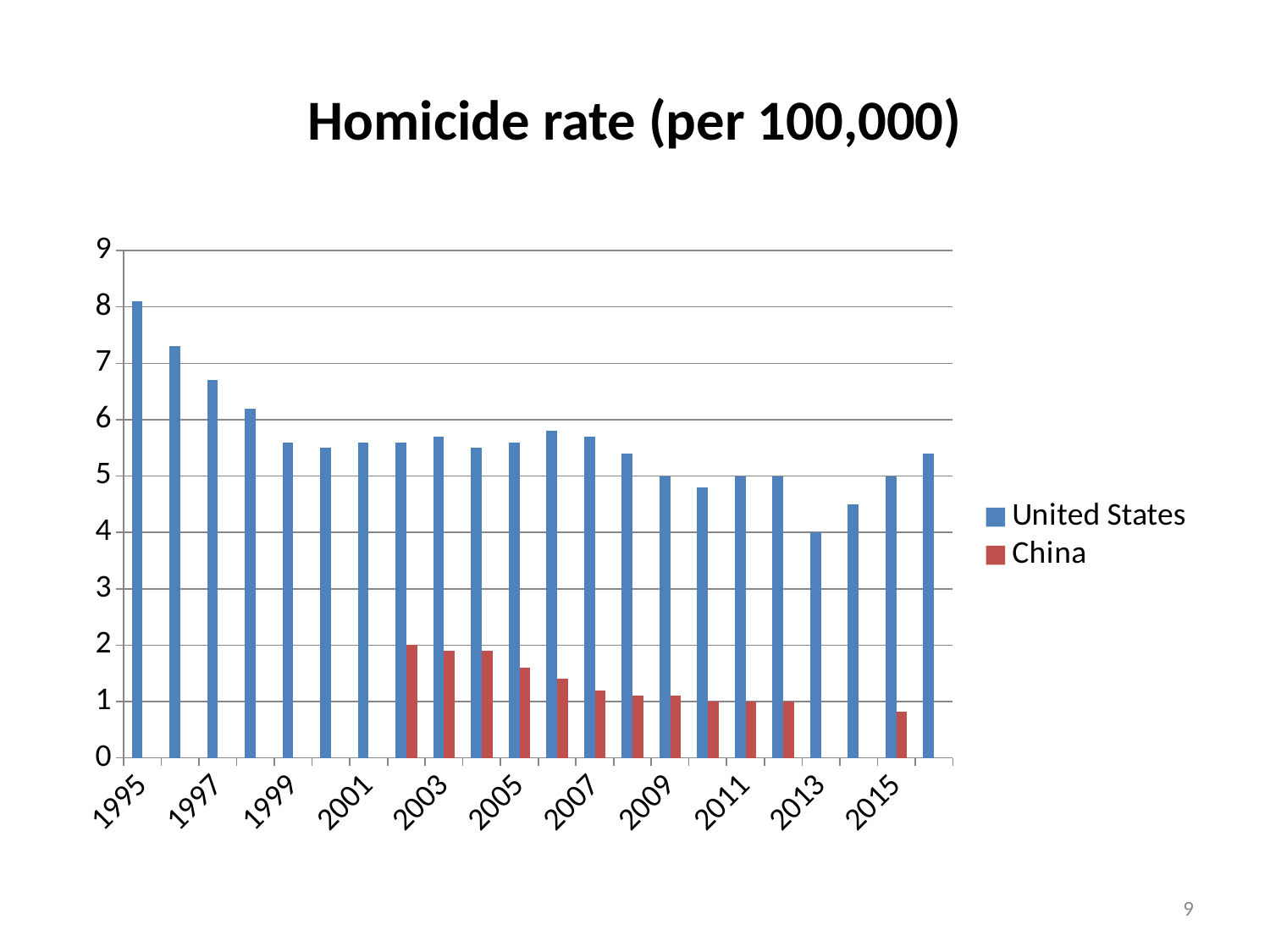
Is the China value for 2002 greater or less than 1? greater Is the United States value for 1995 greater or less than 7? greater In which year is the United States homicide rate lowest? 2013 How many series does the legend list? 2 What kind of chart is shown on the slide? Bar chart Is the United States value for 2013 greater or less than 5? less Which is larger, the China value for 2002 or the China value for 2012? 2002 Does the United States homicide rate generally rise or fall from 1995 to 2013? Fall Which is larger, the United States value for 1995 or the United States value for 2016? 1995 What is the title of the chart? Homicide rate (per 100,000) In which year is the United States homicide rate highest? 1995 Which series is shown in red? China